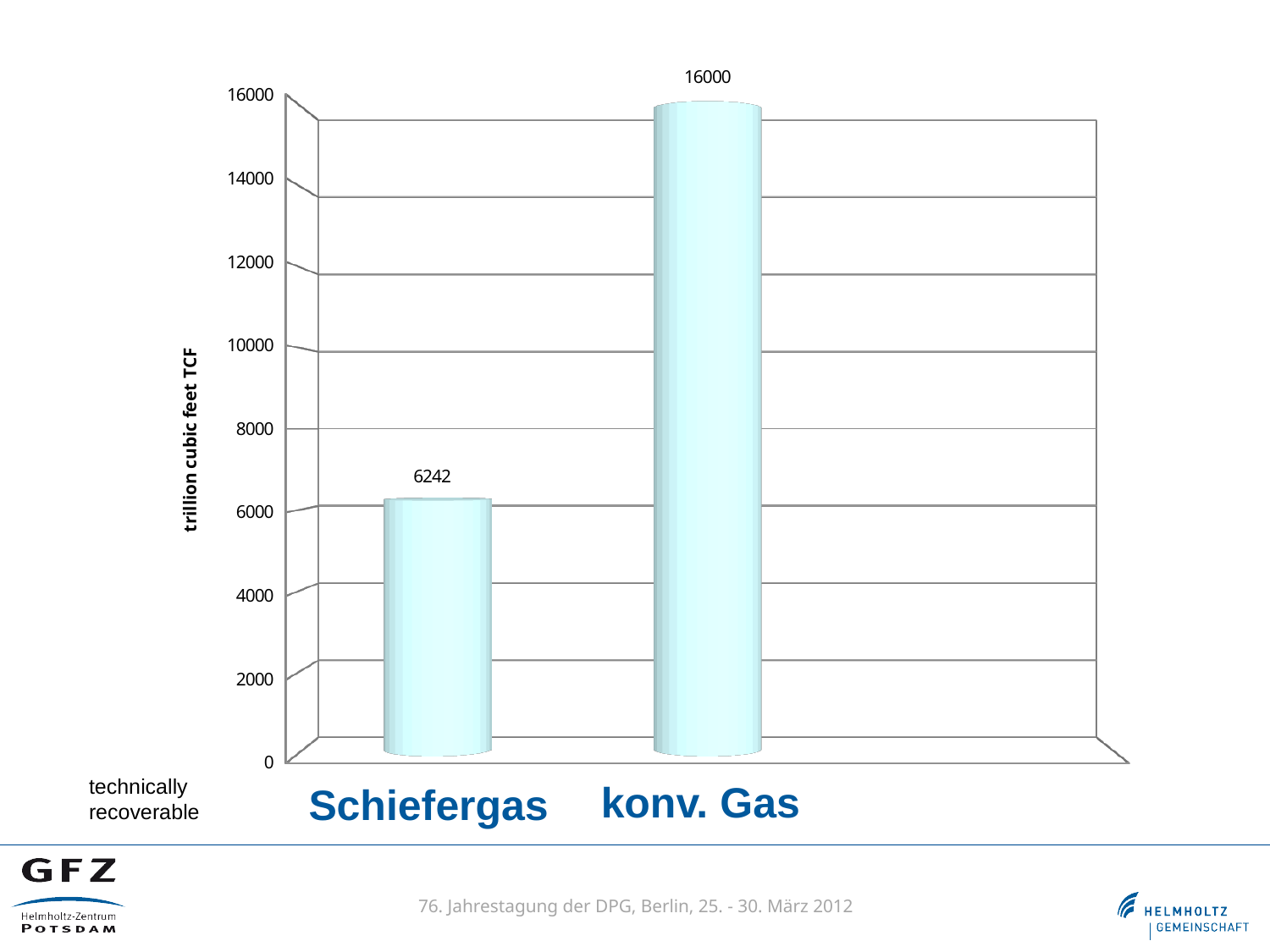
How many categories are shown in the chart? 2 What is the maximum value shown on the vertical axis? 16000 Which category has the lowest value? Schiefergas Is the value for konv. Gas greater or less than 14000? greater Which is larger, the value for Schiefergas or the value for konv. Gas? konv. Gas What is the difference between the values for konv. Gas and Schiefergas? 9758 What is the value for konv. Gas? 16000 Is the value for Schiefergas greater or less than 8000? less What is the value for Schiefergas? 6242 Which category has the highest value? konv. Gas What is the label of the vertical axis? trillion cubic feet TCF What kind of chart is shown on the slide? bar chart